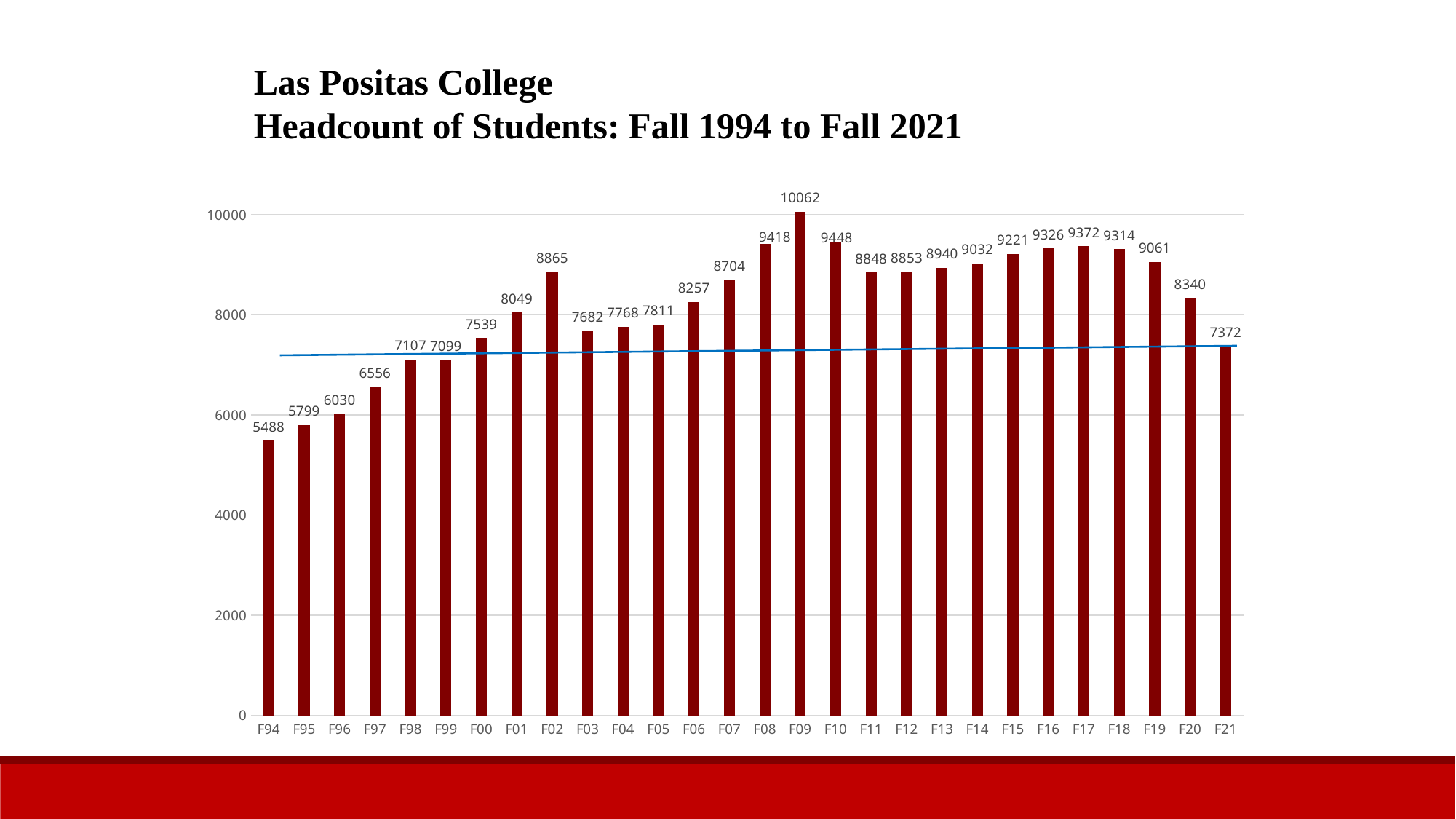
Which term has the lowest headcount? F94 Do the headcount values rise or fall from F94 to F02? rise How many terms are shown on the x axis? 28 Which term has the highest headcount? F09 What kind of chart is shown on the slide? bar chart Which is larger, the headcount for F02 or the headcount for F07? F02 What is the headcount for F09? 10062 Is the value for F97 greater or less than 7000? less What is the headcount for F98? 7107 What is the difference between the headcount in F09 and the headcount in F94? 4574 What is the headcount for F21? 7372 What is the difference between the headcount in F20 and the headcount in F21? 968